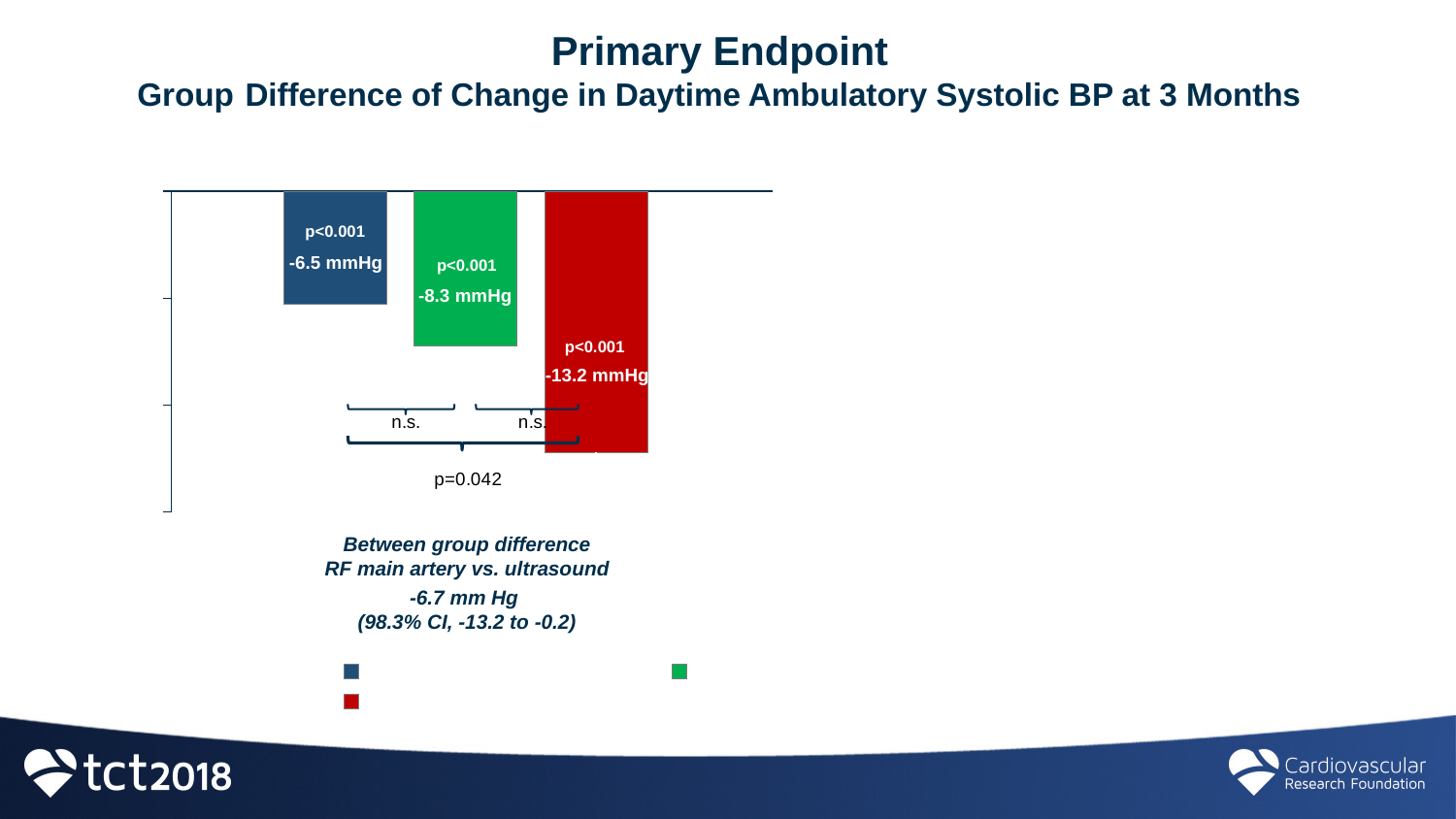
What value is printed on the blue bar? -6.5 mmHg What kind of chart is shown on the slide? bar chart What value is printed on the red bar? -13.2 mmHg Which bar shows the largest reduction in daytime ambulatory systolic BP? the red bar What value is printed on the green bar? -8.3 mmHg How many bars are plotted in the chart? 3 Which bar shows the smallest reduction in daytime ambulatory systolic BP? the blue bar By how many mmHg does the reduction shown by the green bar exceed the reduction shown by the blue bar? 1.8 mmHg Which bar shows a larger reduction, the green bar or the red bar? the red bar What p-value is printed on each of the three bars? p<0.001 By how many mmHg does the reduction shown by the red bar exceed the reduction shown by the blue bar? 6.7 mmHg What p-value is shown for the comparison bracket spanning the blue and red bars? p=0.042